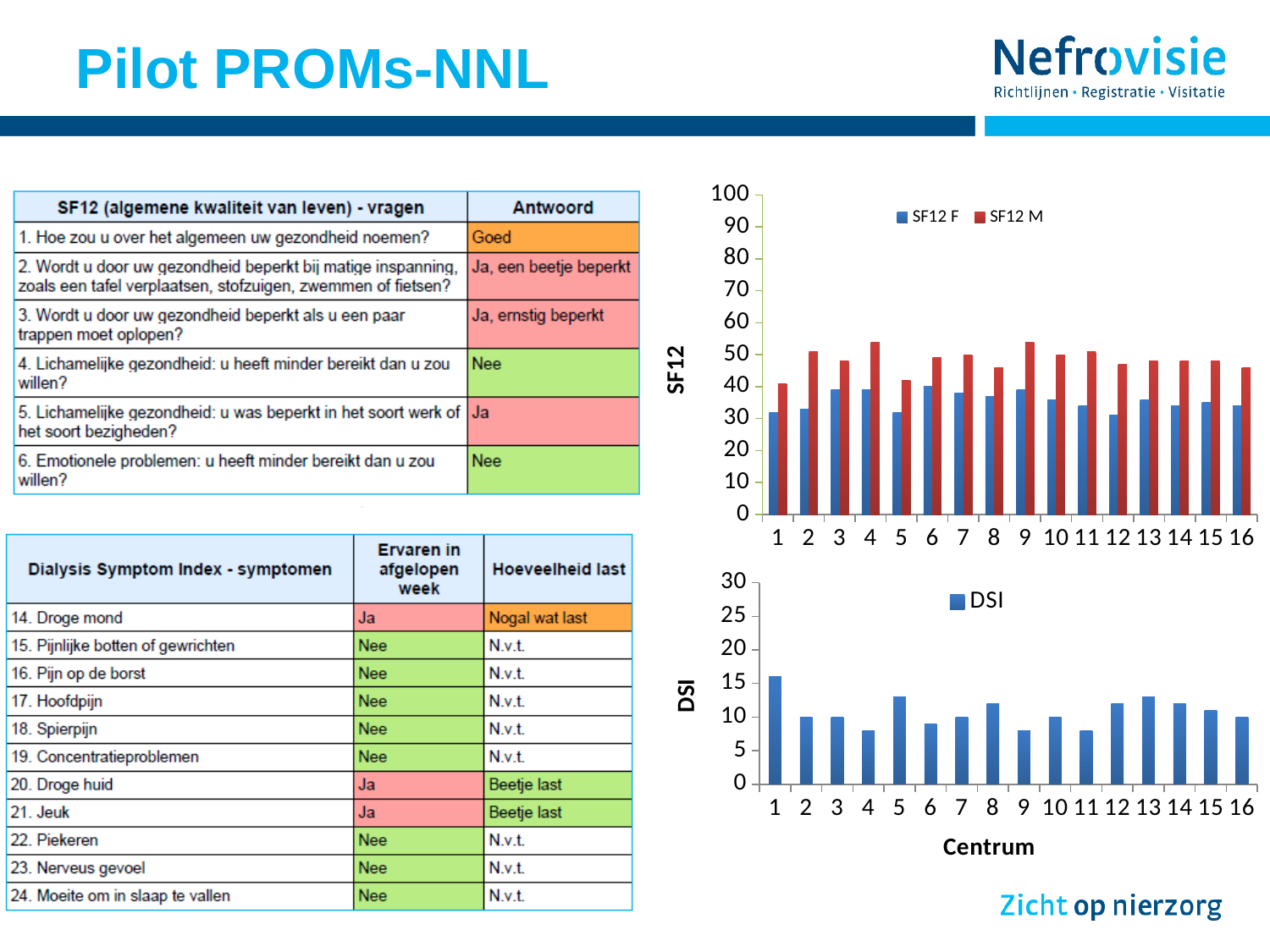
In the SF12 chart, which series has the larger value at centrum 9, SF12 F or SF12 M? SF12 M In the SF12 chart, is the SF12 F value for centrum 1 greater or less than 40? less How many centra are shown on the x axis of the DSI chart? 16 In the SF12 chart, is the SF12 M value for centrum 4 greater or less than 50? greater In the SF12 chart, which series has the larger value at centrum 1, SF12 F or SF12 M? SF12 M In the DSI chart, is the value for centrum 1 greater or less than 15? greater In the DSI chart, which centrum has the highest DSI value? 1 What kind of chart is the SF12 chart at the top right of the slide? bar chart What is the x-axis title of the DSI chart? Centrum How many series does the legend of the SF12 chart list? 2